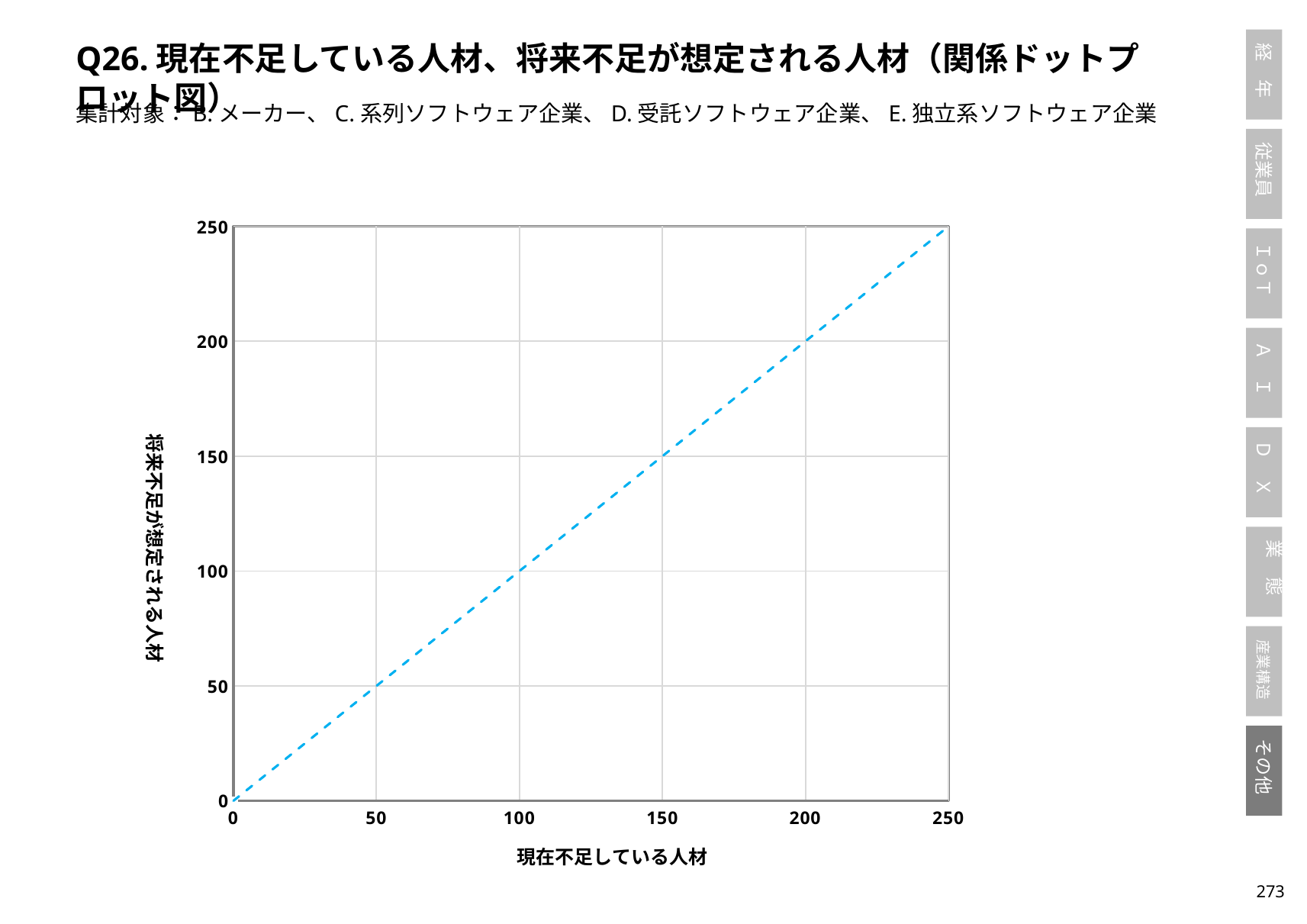
Does the dashed line rise or fall as the x-axis value increases? rise What y-axis value does the dashed line pass through when the x-axis value is 200? 200 What kind of chart is shown on the slide? scatter plot What y-axis value does the dashed line pass through when the x-axis value is 50? 50 What is the title of the y axis of the chart? 将来不足が想定される人材 What is the title of the x axis of the chart? 現在不足している人材